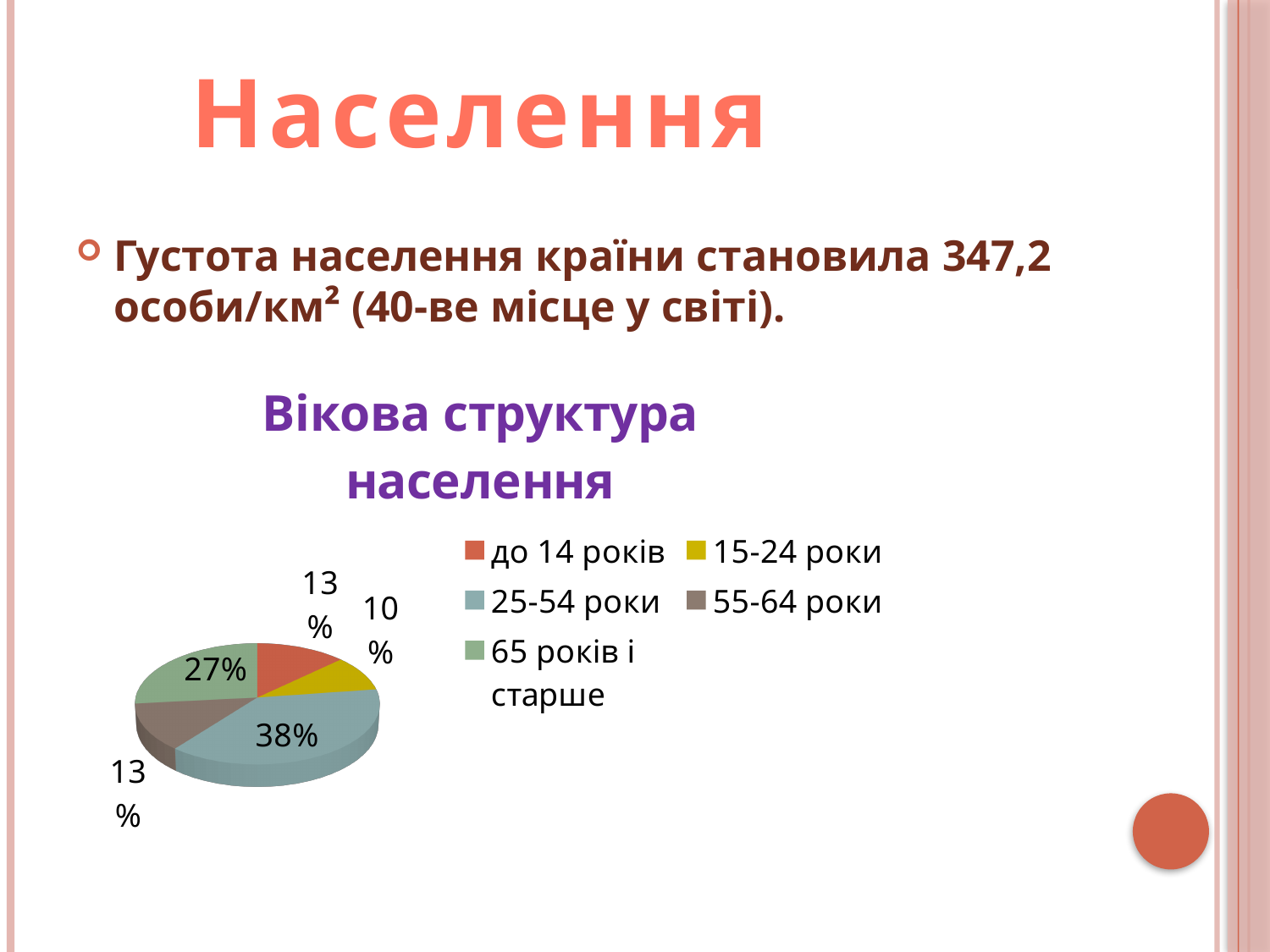
What share of the population is in the до 14 років group? 13% What share of the population is in the 25-54 роки group? 38% What is the difference between the share of the 25-54 роки group and the 65 років і старше group? 11% What is the title of the chart? Вікова структура населення What share of the population is in the 65 років і старше group? 27% Which age group has the smallest share of the population? 15-24 роки Which age group has the largest share of the population? 25-54 роки Which is larger: the share of the 65 років і старше group or the 55-64 роки group? 65 років і старше How many slices does the pie chart have? 5 How many categories does the legend of the pie chart list? 5 What share of the population is in the 15-24 роки group? 10% What kind of chart is shown on the slide? pie chart